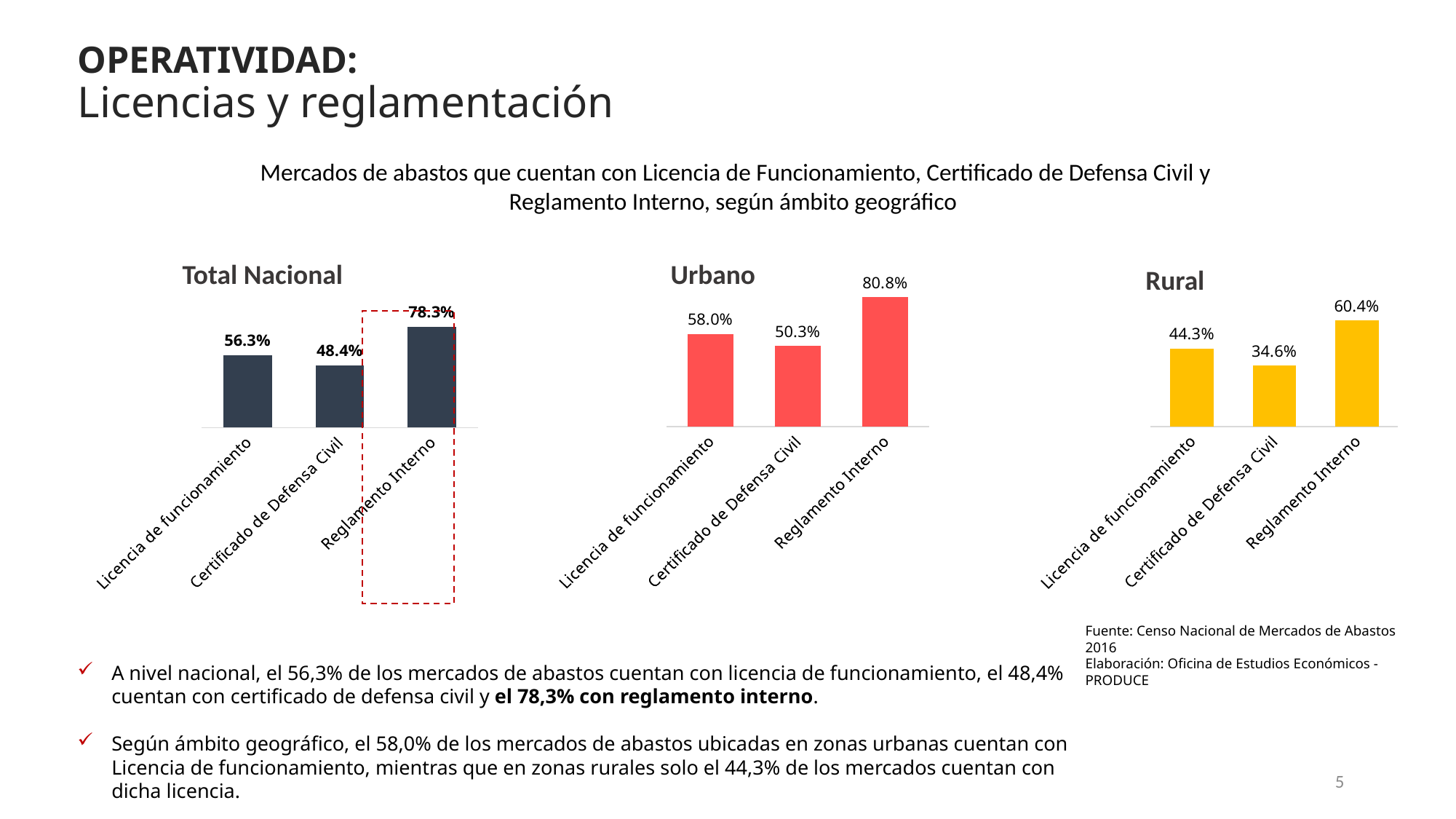
In the Urbano chart, which category has the lowest value? Certificado de Defensa Civil What colour are the bars in the Urbano chart? Red In the Total Nacional chart, what is the value for Certificado de Defensa Civil? 48.4% In the Rural chart, which category has the highest value? Reglamento Interno In the Urbano chart, what is the value for Reglamento Interno? 80.8% In the Total Nacional chart, what is the difference between Reglamento Interno and Licencia de funcionamiento? 22.0% What type of chart is the Rural chart? Bar chart How many categories does the Urbano chart show? 3 In the Total Nacional chart, what is the value for Licencia de funcionamiento? 56.3% In the Rural chart, what is the value for Certificado de Defensa Civil? 34.6% Which is larger: Licencia de funcionamiento in the Urbano chart or Licencia de funcionamiento in the Rural chart? Urbano In the Rural chart, what is the difference between Licencia de funcionamiento and Certificado de Defensa Civil? 9.7%